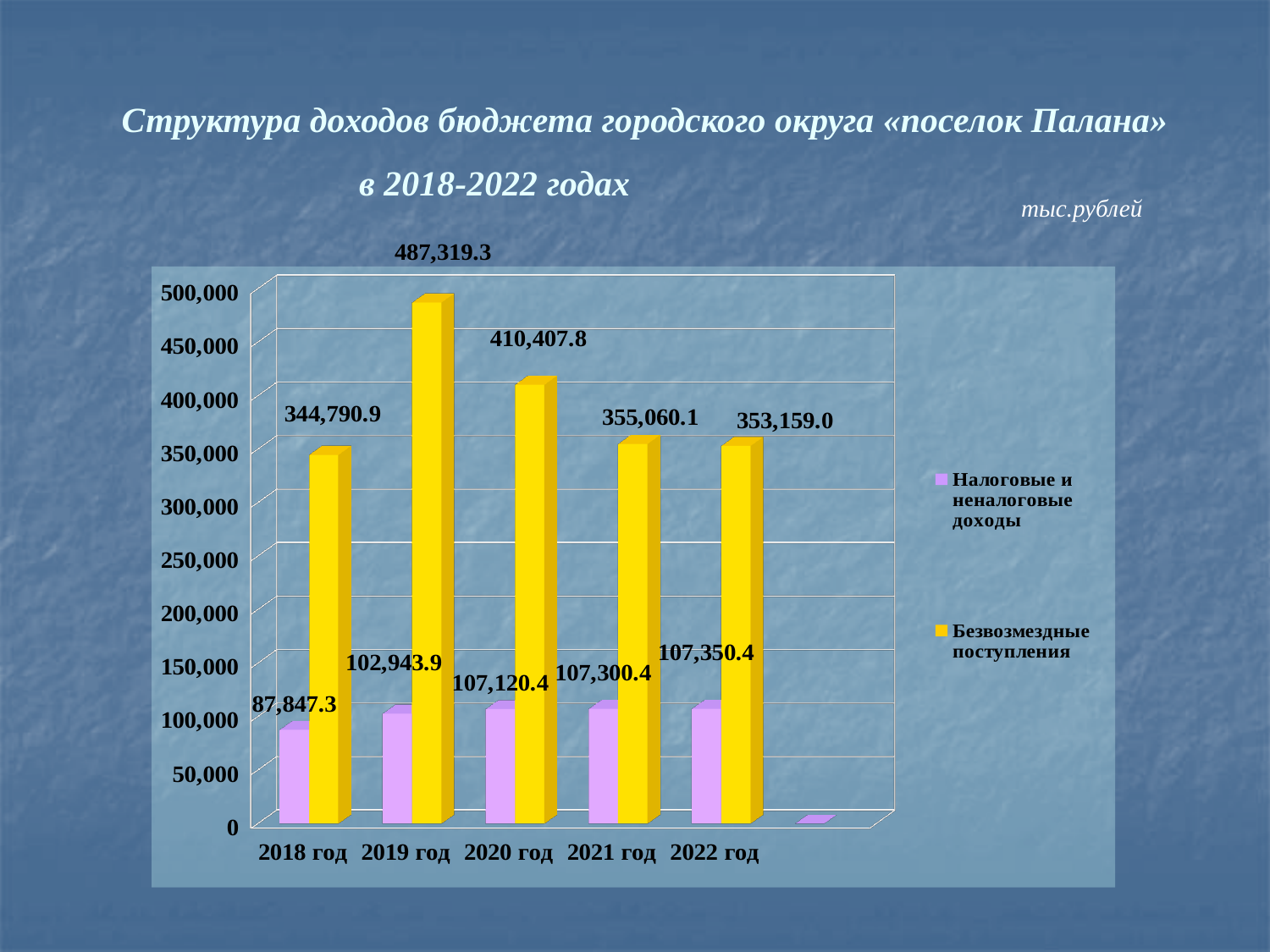
Is the value of Безвозмездные поступления for 2020 год greater or less than 400,000? greater What is the value of Безвозмездные поступления for 2019 год? 487,319.3 How many series does the legend list? 2 In which year is Налоговые и неналоговые доходы lowest? 2018 год What unit is indicated above the chart? тыс.рублей In which year is Безвозмездные поступления highest? 2019 год What is the difference between Безвозмездные поступления in 2019 год and 2018 год? 142,528.4 What is the value of Налоговые и неналоговые доходы for 2018 год? 87,847.3 What type of chart is shown on the slide? bar chart How many years are shown on the x axis? 5 Which is larger: Безвозмездные поступления in 2019 год or in 2020 год? 2019 год What is the value of Безвозмездные поступления for 2022 год? 353,159.0